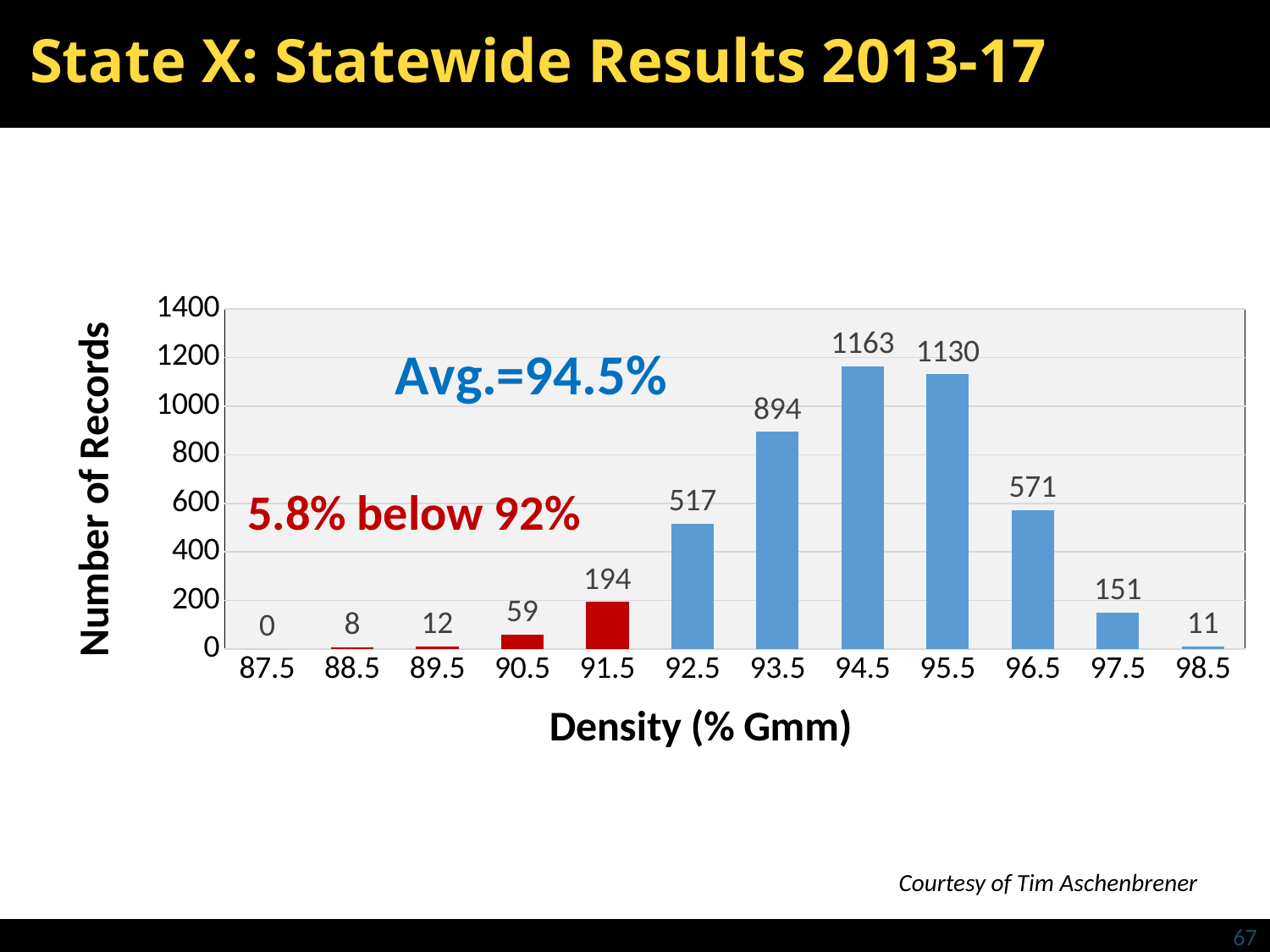
Which has more records, density 93.5 or density 96.5? 93.5 Which density category has the lowest number of records? 87.5 How many density categories are shown on the x axis? 12 What is the number of records for density 94.5? 1163 What is the difference in number of records between density 94.5 and density 95.5? 33 What average value is annotated on the chart? Avg.=94.5% What is the label of the x axis? Density (% Gmm) What kind of chart is shown on the slide? bar chart Which density category has the highest number of records? 94.5 Do the number of records rise or fall from density 95.5 to density 98.5? fall What is the number of records for density 91.5? 194 What is the number of records for density 92.5? 517